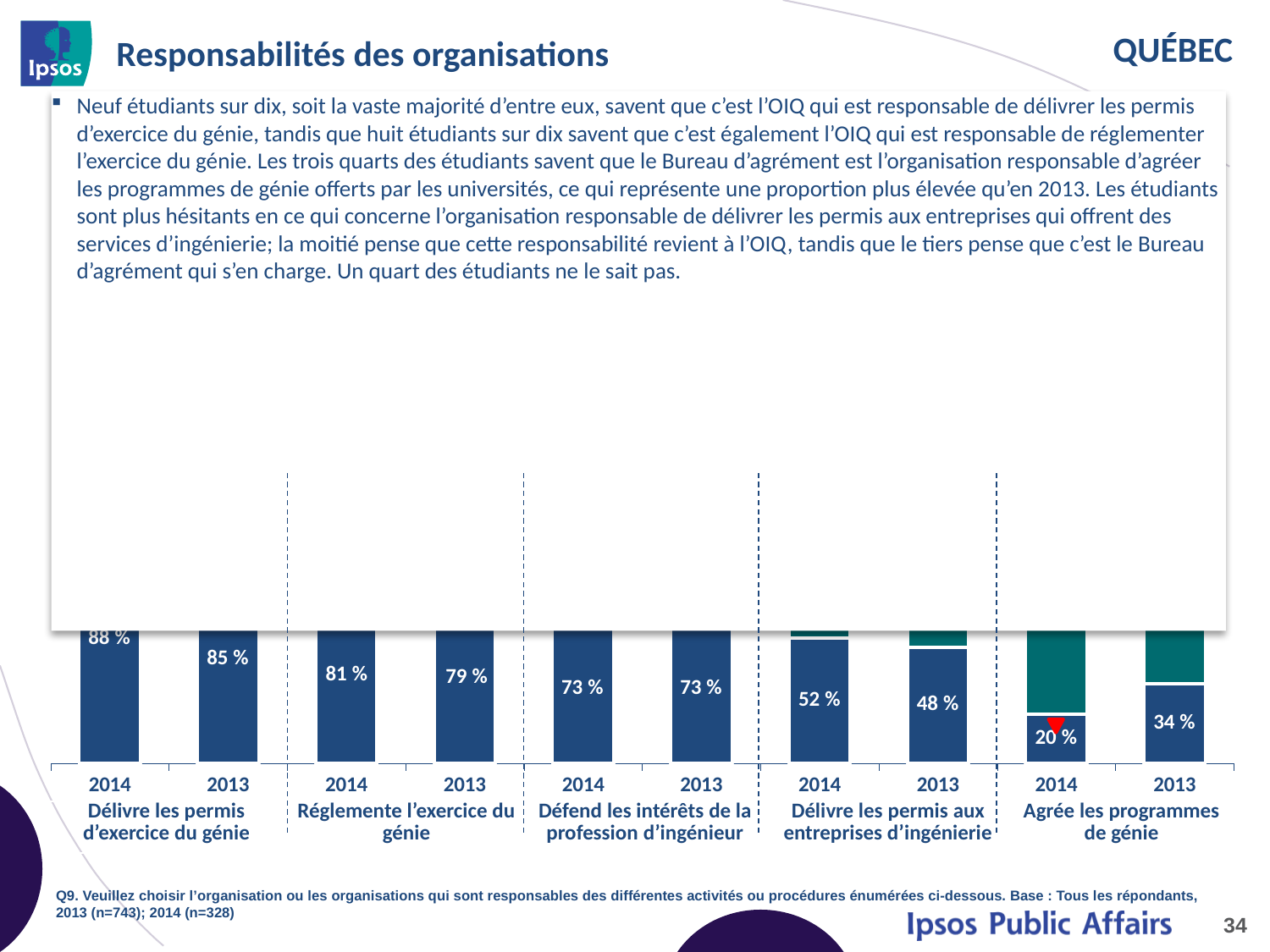
What is the difference between the 2013 and 2014 labelled values for "Agrée les programmes de génie"? 14 percentage points What is the value shown for 2014 under "Délivre les permis d'exercice du génie"? 88 % What is the value shown for 2013 under "Délivre les permis aux entreprises d'ingénierie"? 48 % What is the value shown for 2013 under "Réglemente l'exercice du génie"? 79 % Which bar has the lowest labelled value on the chart? 2014, Agrée les programmes de génie (20 %) What is the labelled value for 2014 under "Agrée les programmes de génie"? 20 % How many activity categories are shown along the x axis of the chart? 5 What kind of chart is shown on the slide? Bar chart What is the difference between the 2014 and 2013 labelled values for "Délivre les permis d'exercice du génie"? 3 percentage points What is the difference between the 2014 and 2013 labelled values for "Défend les intérêts de la profession d'ingénieur"? 0 percentage points Which bar has the highest labelled value on the chart? 2014, Délivre les permis d'exercice du génie (88 %) For "Délivre les permis aux entreprises d'ingénierie", which year has the larger labelled value, 2014 or 2013? 2014